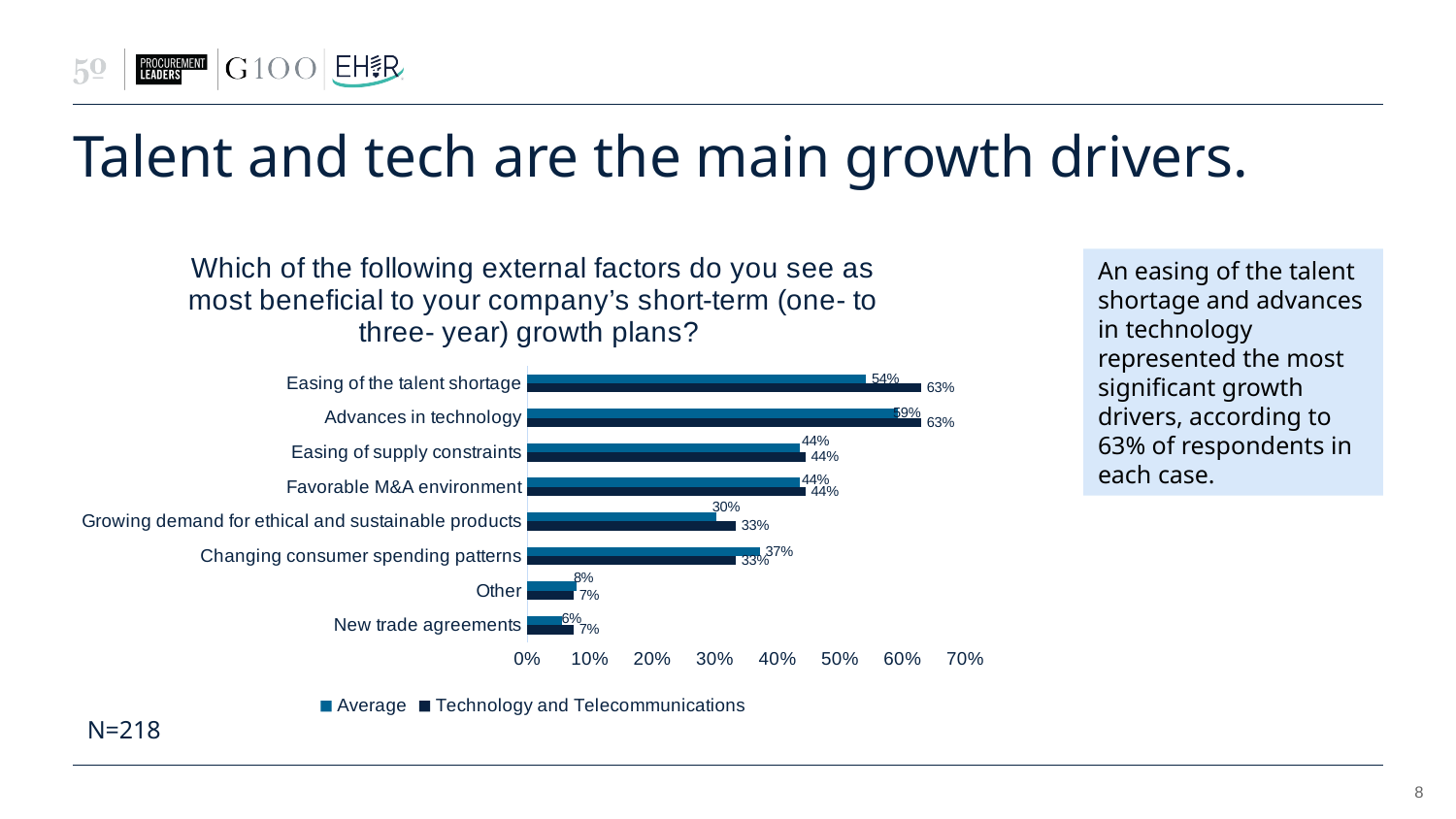
What is the Average value for Changing consumer spending patterns? 37% Which category has the highest Average value? Advances in technology For Changing consumer spending patterns, which series has the larger value, Average or Technology and Telecommunications? Average What is the Average value for Easing of the talent shortage? 54% Is the Average value for Advances in technology greater or less than 50%? greater What is the Technology and Telecommunications value for Advances in technology? 63% What is the Technology and Telecommunications value for Growing demand for ethical and sustainable products? 33% Which category has the lowest Average value? New trade agreements What type of chart is shown on the slide? Bar chart How many categories are shown in the chart? 8 What is the difference between the Technology and Telecommunications value and the Average value for Easing of the talent shortage? 9% How many series does the legend list? 2